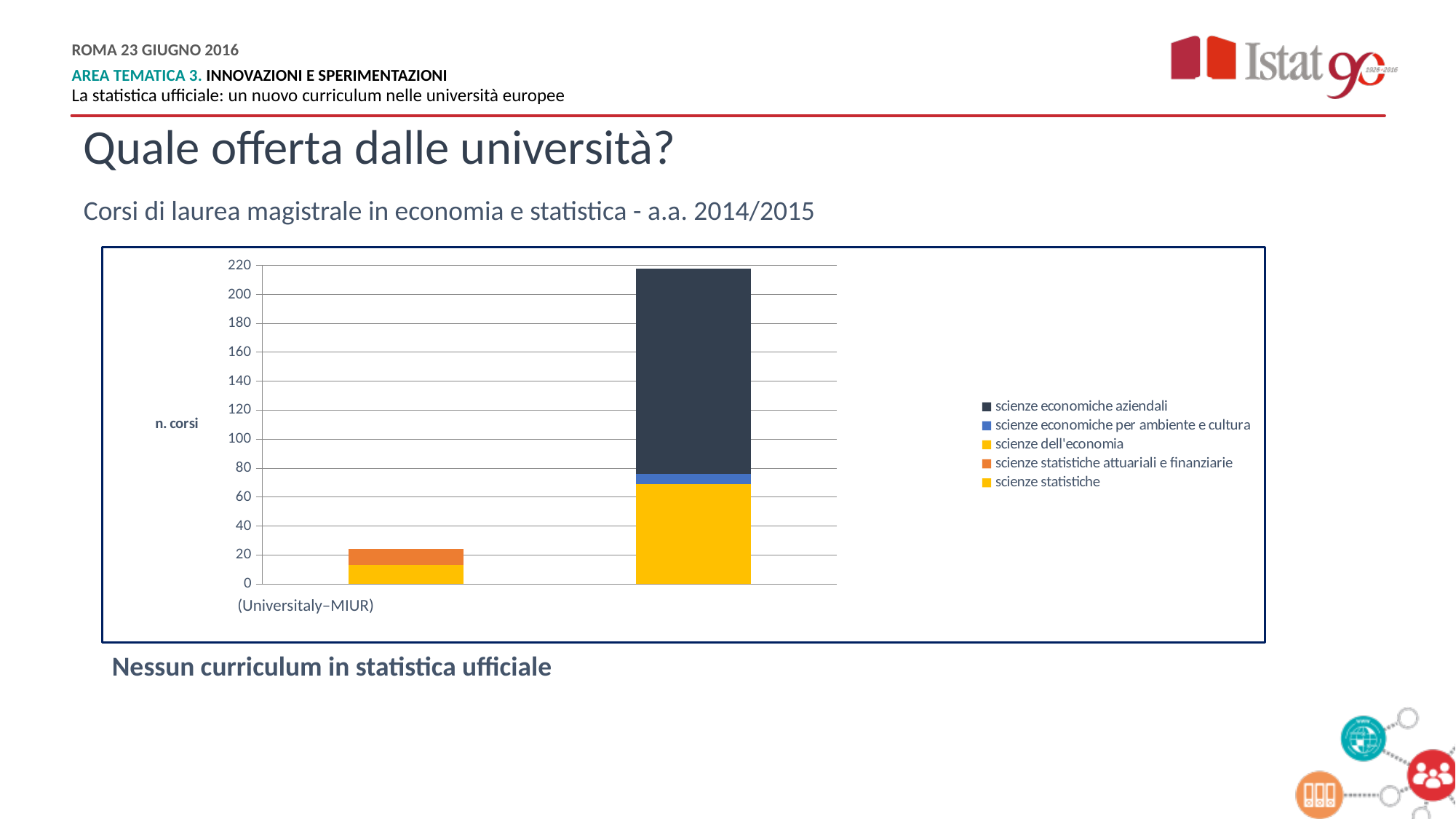
How many series does the chart legend list? 5 What source is cited below the chart? (Universitaly–MIUR) Which series forms the largest segment in the chart? scienze economiche aziendali What kind of chart is shown on the slide? Stacked bar chart Is the total height of the right bar greater or less than 200? greater Is the total height of the left bar greater or less than 40? less Is the value of the 'scienze economiche aziendali' segment greater or less than 100? greater Which of the two bars is taller, the left one or the right one? The right one How many bars are plotted in the chart? 2 What is the label on the vertical axis of the chart? n. corsi